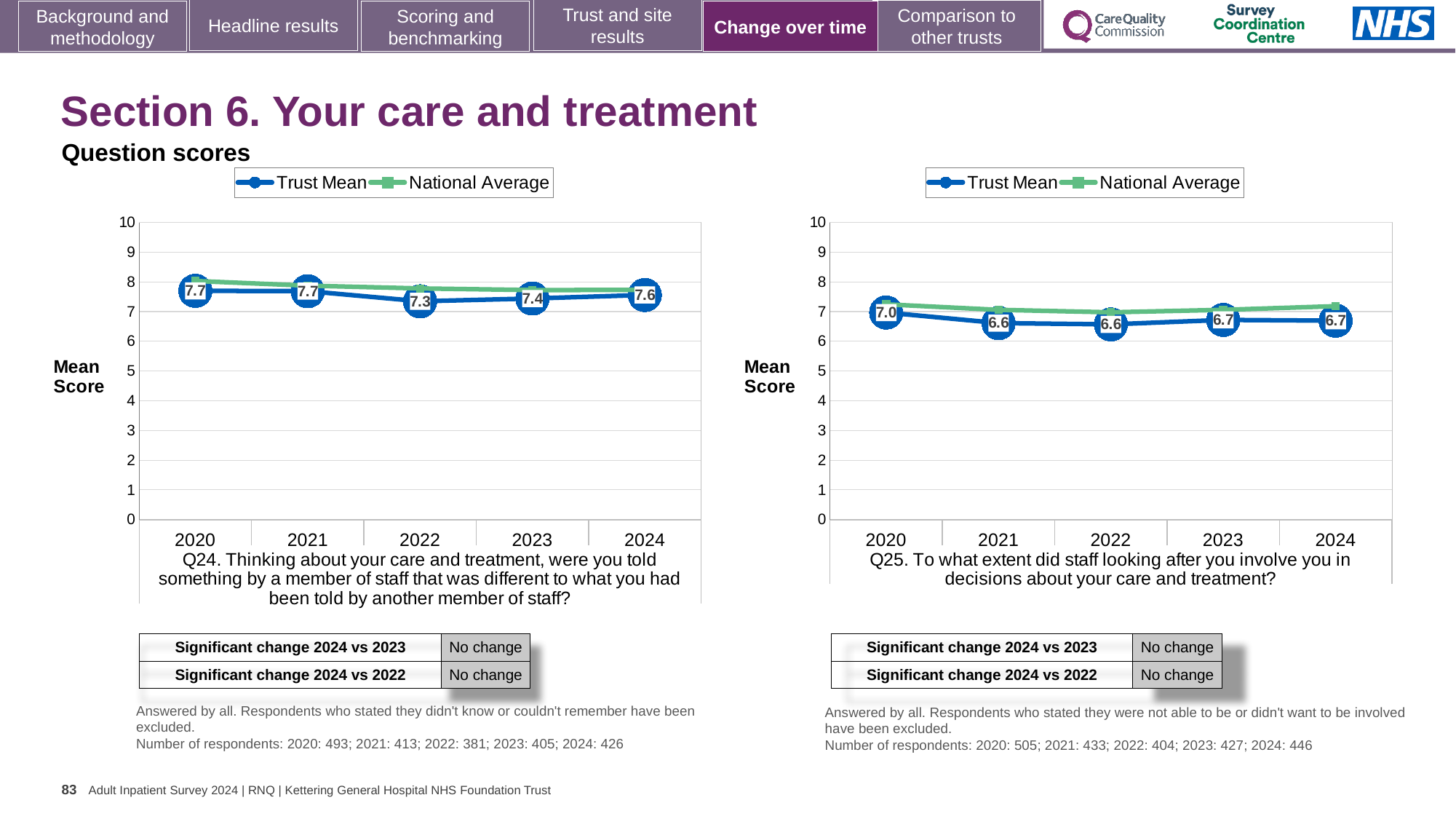
On the Q25 chart (right), what is the Trust Mean score for 2020? 7.0 How many series does the legend of the Q24 chart (left) list? 2 What type of chart is used for the Q25 chart (right)? Line chart On the Q24 chart (left), is the Trust Mean score higher in 2022 or in 2024? 2024 On the Q24 chart (left), what is the difference between the Trust Mean scores for 2020 and 2022? 0.4 On the Q25 chart (right), what is the Trust Mean score for 2023? 6.7 On the Q24 chart (left), what is the Trust Mean score for 2022? 7.3 On the Q24 chart (left), which year has the lowest Trust Mean score? 2022 On the Q24 chart (left), what is the Trust Mean score for 2024? 7.6 On the Q25 chart (right), what is the difference between the Trust Mean scores for 2020 and 2021? 0.4 On the Q25 chart (right), which year has the highest Trust Mean score? 2020 How many years are plotted on the Q25 chart (right)? 5